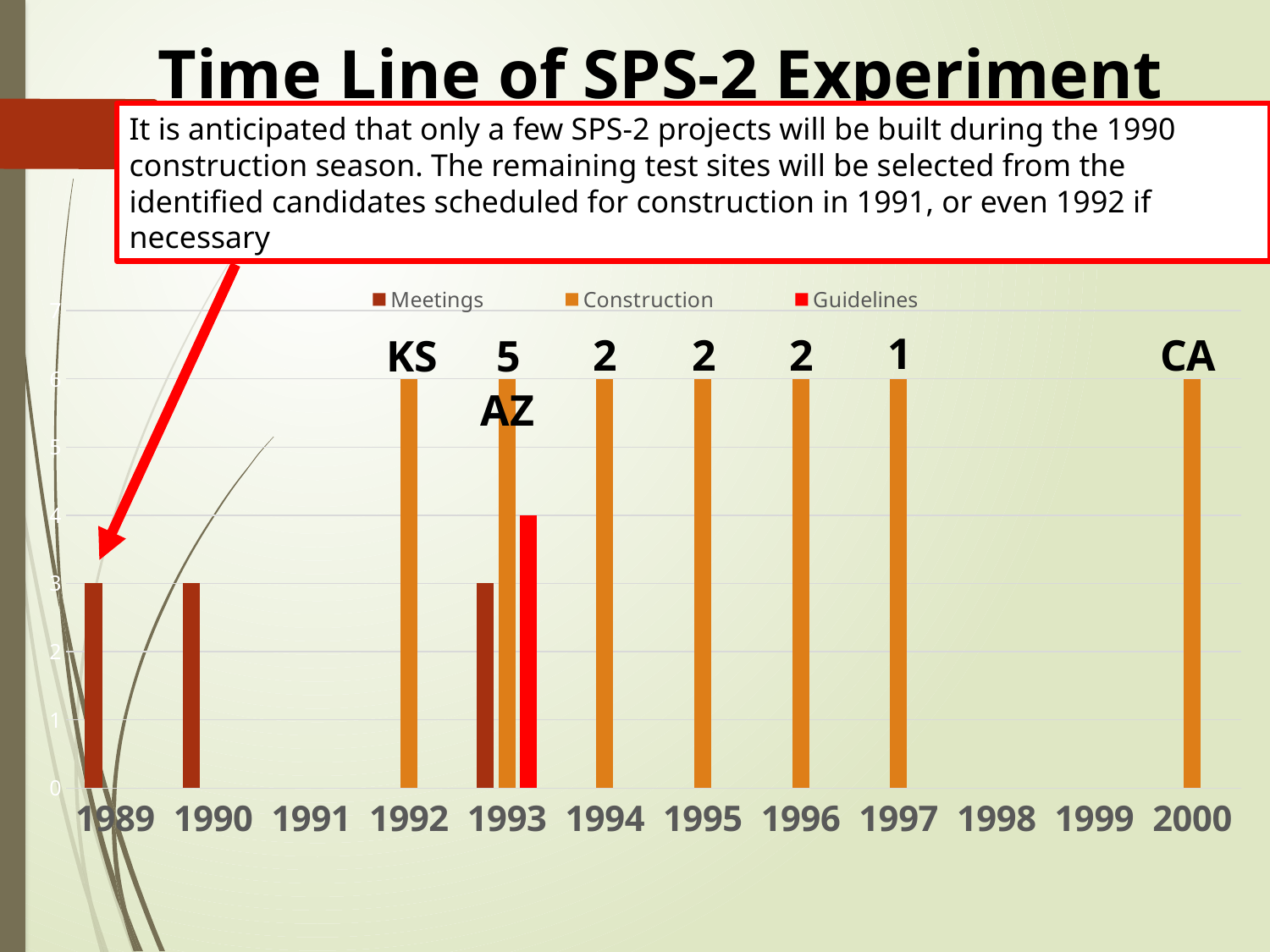
What are the three series named in the chart legend? Meetings, Construction, Guidelines Is the Meetings value for 1989 greater or less than 2? greater How many years are shown along the x axis of the chart? 12 How many series does the chart legend list? 3 Which years on the x axis have no bars at all? 1991, 1998, 1999 In 1993, which is larger: the Construction bar or the Guidelines bar? Construction What is the title of the slide containing the chart? Time Line of SPS-2 Experiment In which years does the chart show a Meetings bar? 1989, 1990, 1993 In 1993, which is larger: the Meetings bar or the Guidelines bar? Guidelines Is the Construction value for 1992 greater or less than 5? greater Is the Guidelines value for 1993 greater or less than 5? less What kind of chart is shown on the slide? bar chart